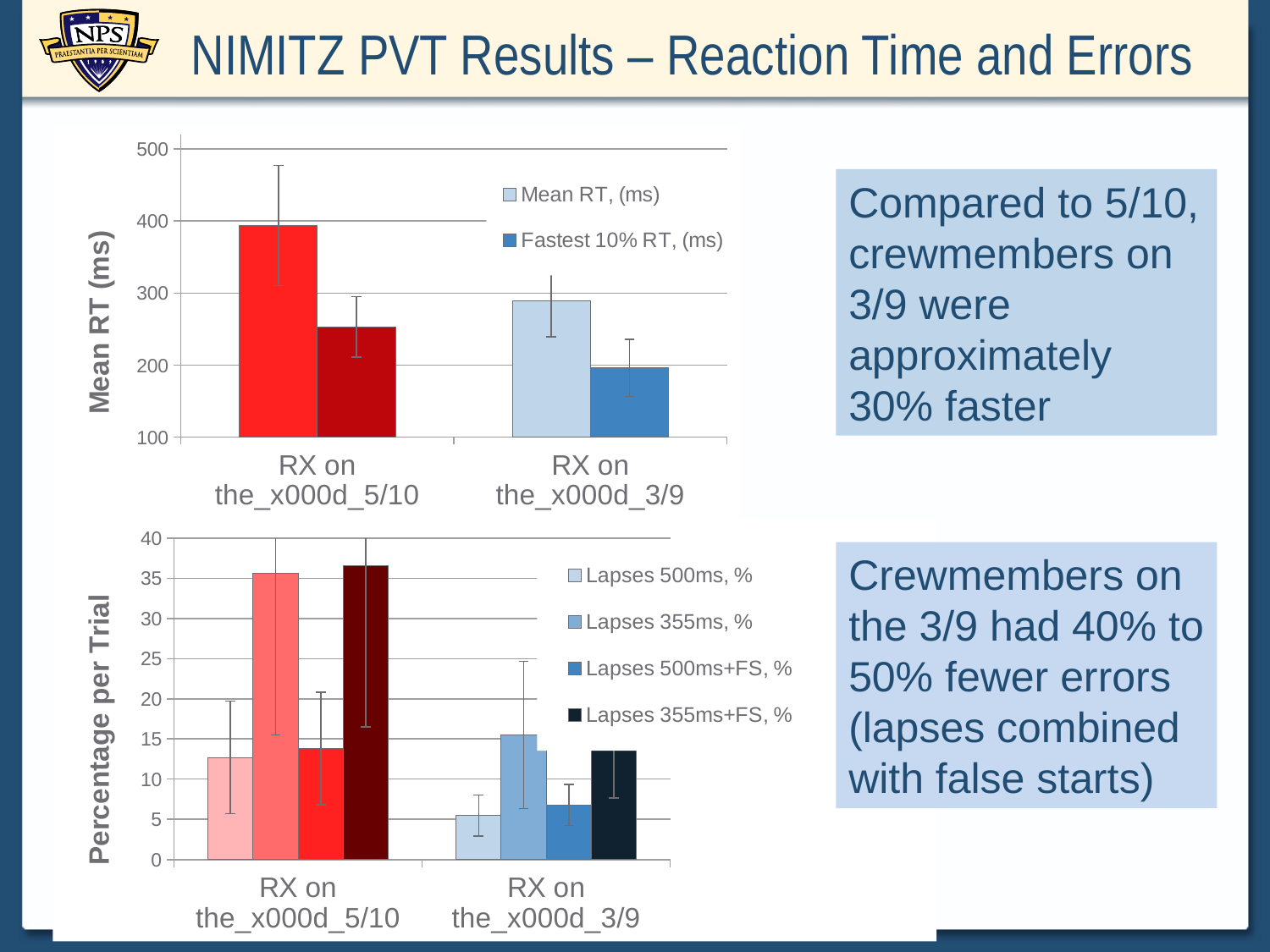
In the top chart, which category has the higher Mean RT, RX on the 5/10 or RX on the 3/9? RX on the 5/10 What is the y-axis title of the bottom chart? Percentage per Trial In the top chart, is the Mean RT value for RX on the 5/10 greater or less than 300? greater In the bottom chart, is the Lapses 500ms value for RX on the 3/9 greater or less than 10? less In the bottom chart, how many categories are shown on the x axis? 2 In the bottom chart, is the Lapses 355ms value for RX on the 5/10 greater or less than 30? greater In the top chart, what kind of chart is used to show the reaction time data? bar chart In the bottom chart, how many series does the legend list? 4 What is the y-axis title of the top chart? Mean RT (ms) In the bottom chart, which category has the higher Lapses 355ms+FS value, RX on the 5/10 or RX on the 3/9? RX on the 5/10 In the top chart, how many series does the legend list? 2